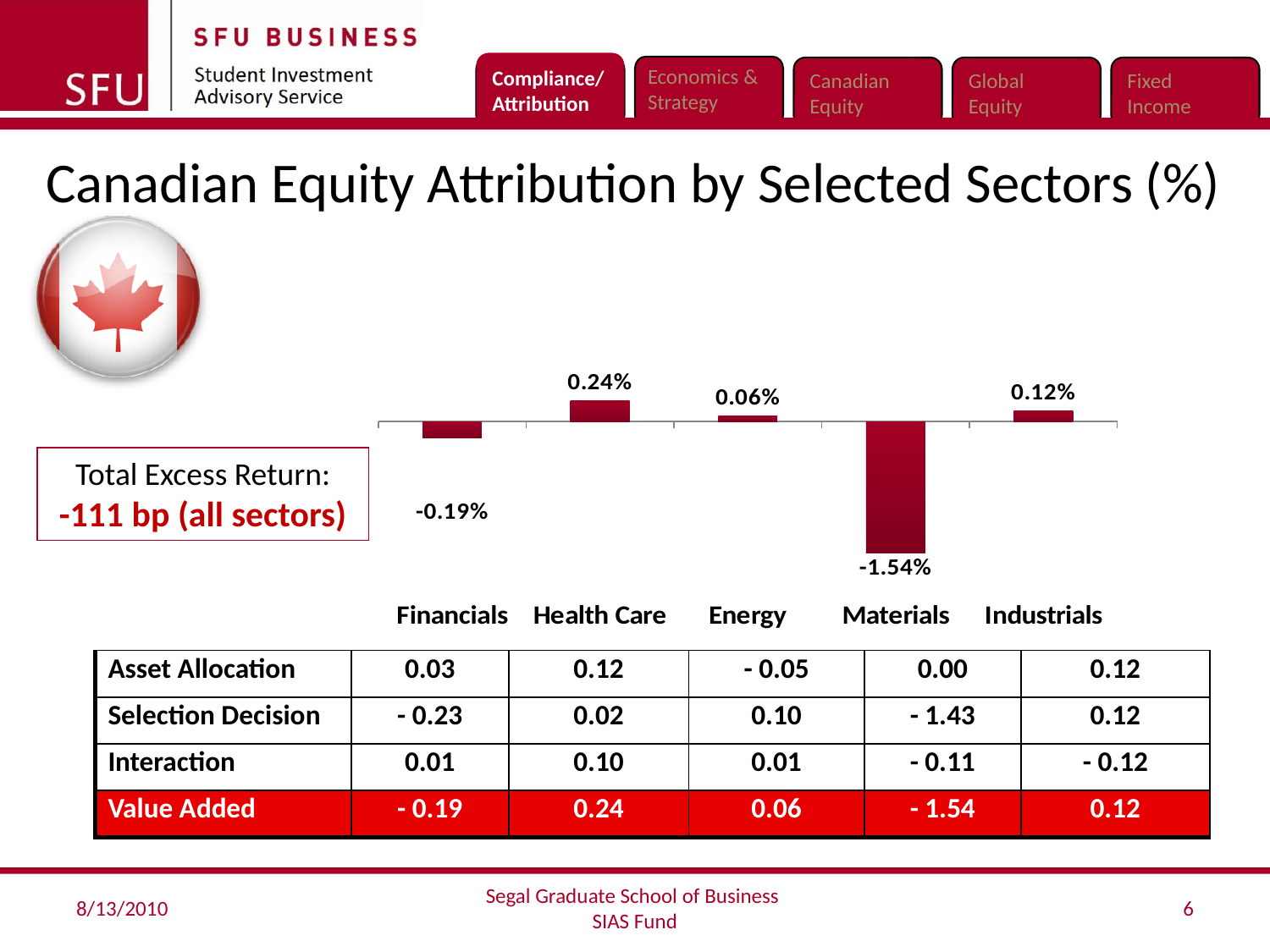
What kind of chart is shown on the slide? Bar chart What is the title of the chart on the slide? Canadian Equity Attribution by Selected Sectors (%) What is the value shown for Health Care in the bar chart? 0.24% How many sectors in the bar chart have a negative value? 2 What is the value shown for Financials in the bar chart? -0.19% Which is larger in the bar chart, the value for Energy or the value for Industrials? Industrials What is the difference between the Health Care value and the Industrials value in the bar chart? 0.12% How many sectors are plotted in the bar chart? 5 Which sector has the highest value in the bar chart? Health Care What is the value shown for Industrials in the bar chart? 0.12% Which sector has the lowest value in the bar chart? Materials What is the value shown for Materials in the bar chart? -1.54%